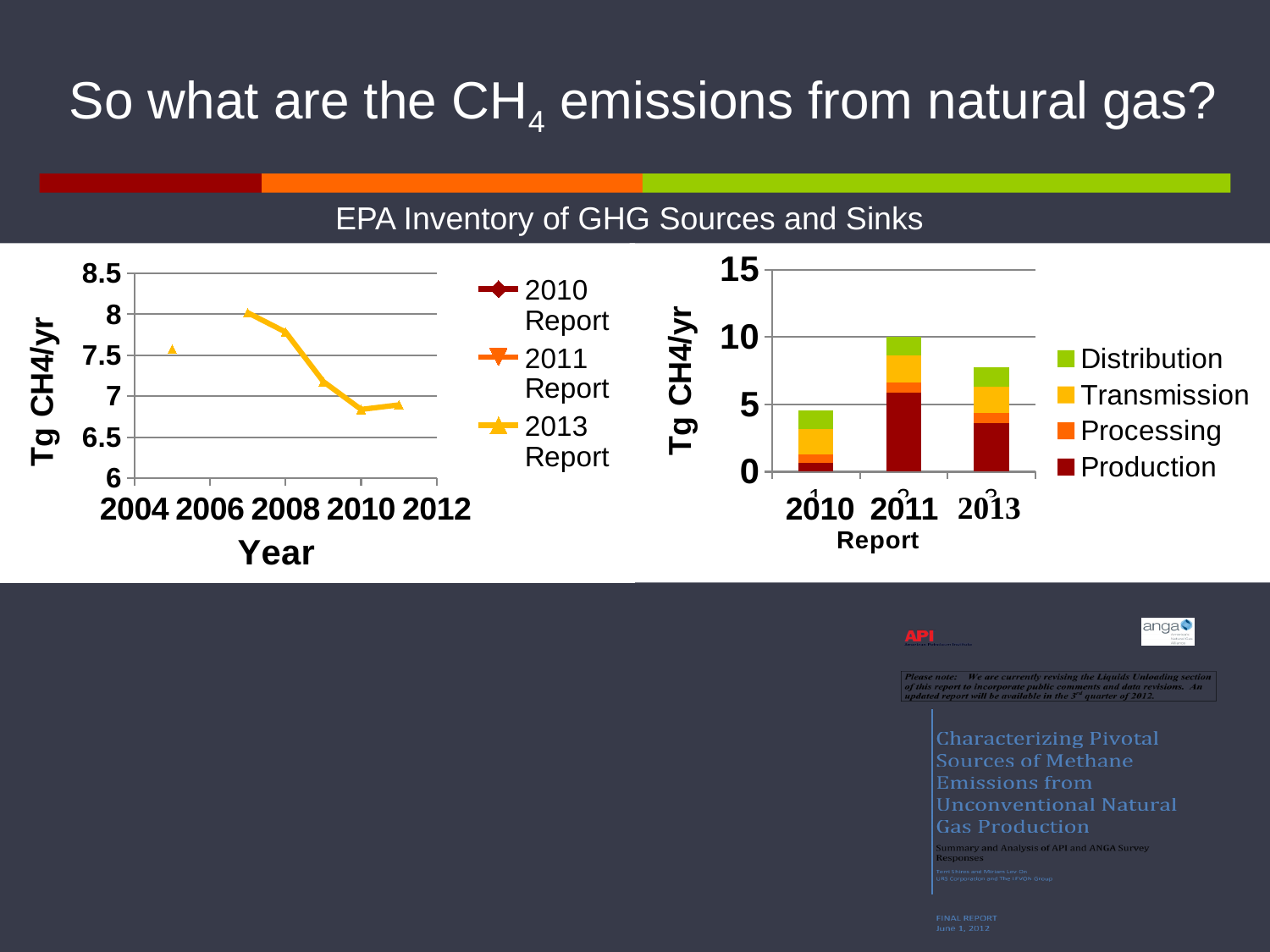
In the right chart, is the total for the 2011 report greater or less than 5? greater In the right chart, which report has the shortest stacked bar? 2010 In the right chart, is the total for the 2010 report greater or less than 10? less In the right chart, which report has the tallest stacked bar? 2011 What kind of chart is the chart on the left of the slide? line chart What is the y-axis label of the right chart? Tg CH4/yr How many report categories are shown on the x axis of the right chart? 3 How many series does the legend of the right chart list? 4 What kind of chart is the chart on the right of the slide? bar chart In the left chart, is the 2013 Report value for 2010 greater or less than 7? less In the left chart, do the 2013 Report values rise or fall between 2007 and 2010? fall How many series does the legend of the left chart list? 3